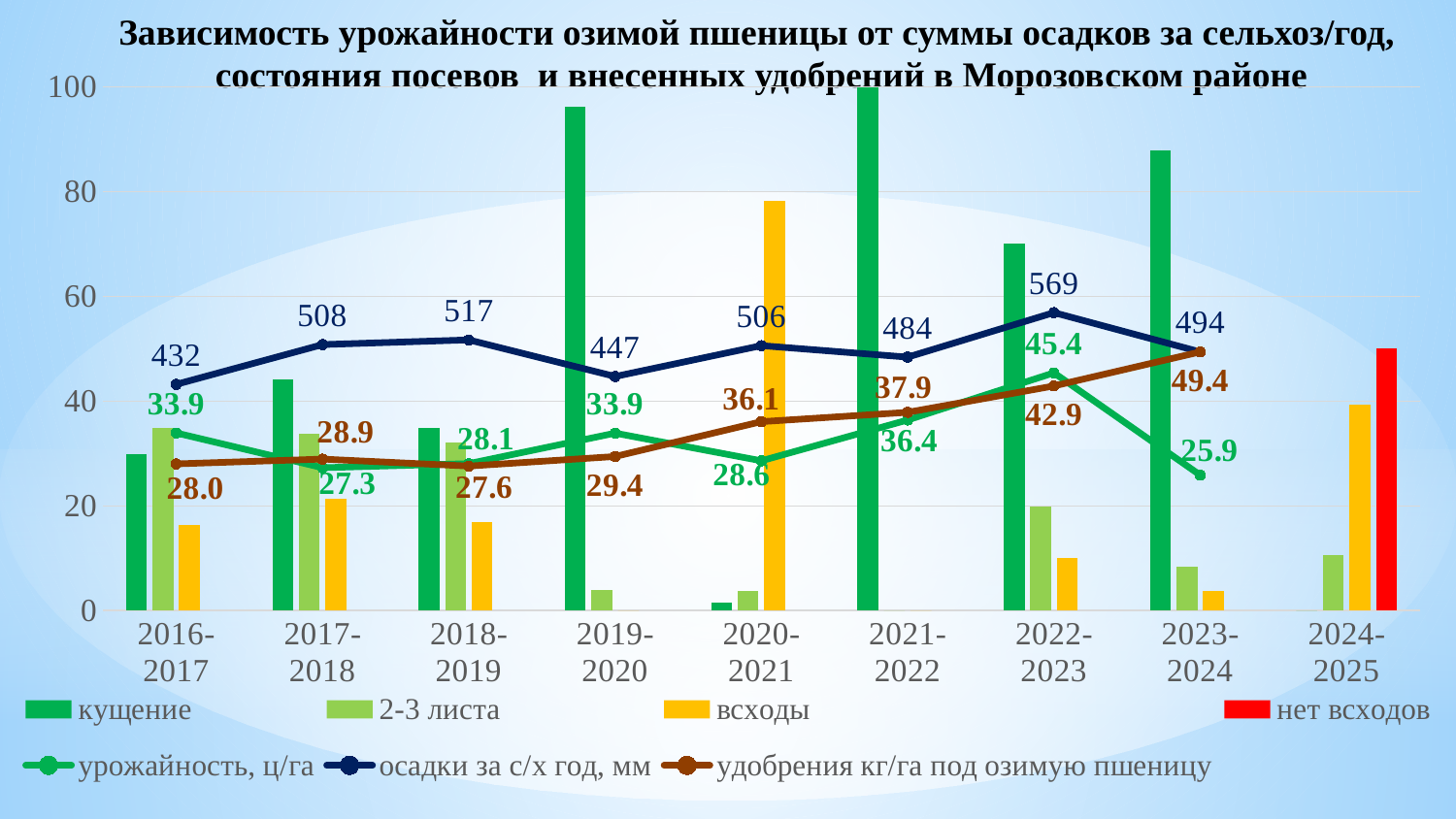
How many seasons are shown on the x axis? 9 What is the value of осадки за с/х год, мм for 2016-2017? 432 How many series does the legend list? 7 Which season has the larger урожайность, ц/га value: 2020-2021 or 2021-2022? 2021-2022 Is the кущение bar for 2021-2022 greater or less than 80? greater What is the difference between the highest and lowest осадки за с/х год, мм values (2022-2023 and 2016-2017)? 137 In which season is урожайность, ц/га lowest? 2023-2024 Does the удобрения кг/га под озимую пшеницу line generally rise or fall from 2016-2017 to 2023-2024? rise In which season is осадки за с/х год, мм highest? 2022-2023 Is the всходы bar for 2020-2021 greater or less than 60? greater What is the удобрения кг/га под озимую пшеницу value for 2020-2021? 36.1 What is the урожайность, ц/га value for 2022-2023? 45.4